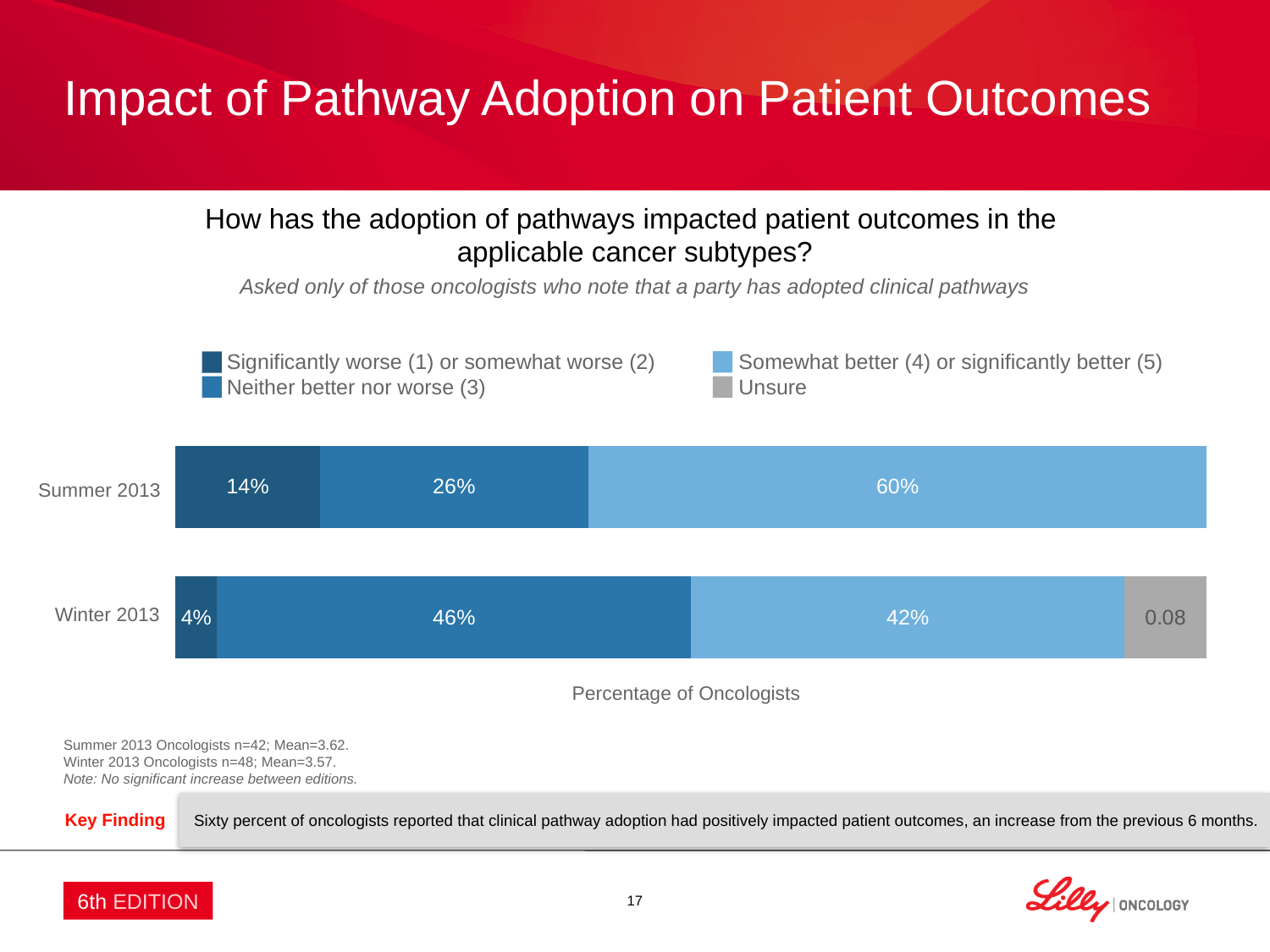
What kind of chart is shown on the slide? Stacked bar chart How many series does the legend list? 4 What is the value for 'Neither better nor worse (3)' in Summer 2013? 26% What is the difference between the 'Somewhat better (4) or significantly better (5)' values for Summer 2013 and Winter 2013? 18% What percentage of oncologists in Summer 2013 said outcomes were somewhat better or significantly better? 60% What is the difference between the 'Neither better nor worse (3)' values for Winter 2013 and Summer 2013? 20% What is the value for 'Neither better nor worse (3)' in Winter 2013? 46% What is the axis label shown below the bars? Percentage of Oncologists What value is shown for the 'Unsure' segment in Winter 2013? 0.08 How many categories (editions) are shown on the chart? 2 What is the value for 'Significantly worse (1) or somewhat worse (2)' in Winter 2013? 4% Which edition has the larger share for 'Somewhat better (4) or significantly better (5)', Summer 2013 or Winter 2013? Summer 2013